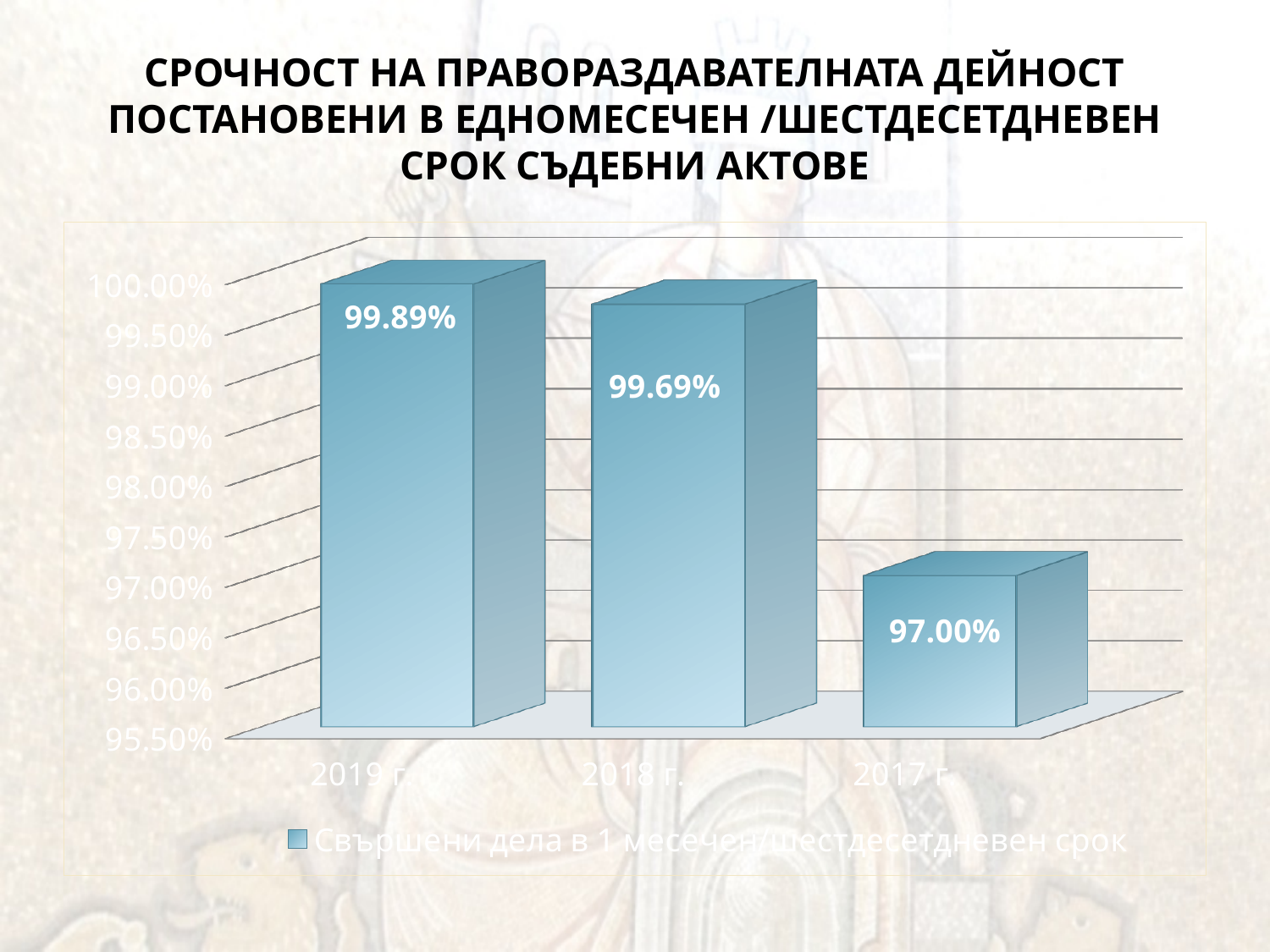
What is the difference between the values for 2019 г. and 2017 г? 2.89% Which is larger, the value for 2018 г. or the value for 2017 г? 2018 г. What is the legend entry of the series shown on the chart? Свършени дела в 1 месечен/шестдесетдневен срок What kind of chart is shown on the slide? bar chart How many years are shown on the chart? 3 Which year has the highest value? 2019 г. Is the value for 2017 г greater or less than 98.00%? less What is the value for 2019 г.? 99.89% What is the value for 2017 г? 97.00% What is the value for 2018 г.? 99.69% Which year has the lowest value? 2017 г What is the difference between the values for 2019 г. and 2018 г.? 0.20%